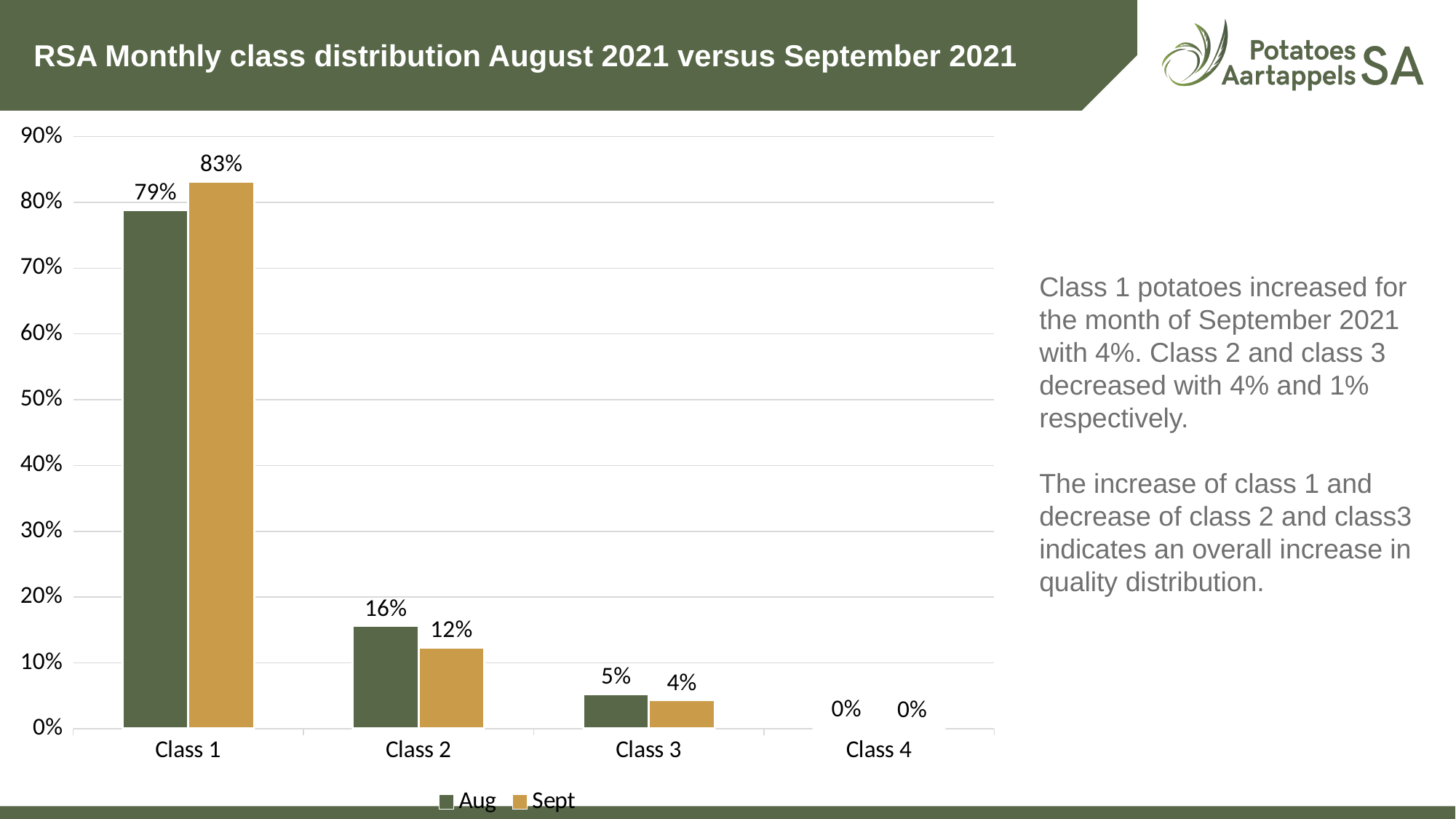
What is the difference between the Sept and Aug values for Class 1? 4% What is the Aug value for Class 2? 16% How many classes are shown on the x axis? 4 Which is larger for Class 3, the Aug value or the Sept value? Aug What is the difference between the Aug and Sept values for Class 2? 4% Is the Aug value for Class 1 greater or less than 70%? greater Which class has the highest Aug value? Class 1 What kind of chart is shown on the slide? Bar chart Which class has the lowest Sept value? Class 4 What is the Sept value for Class 3? 4% How many series does the legend list? 2 What is the Sept value for Class 1? 83%